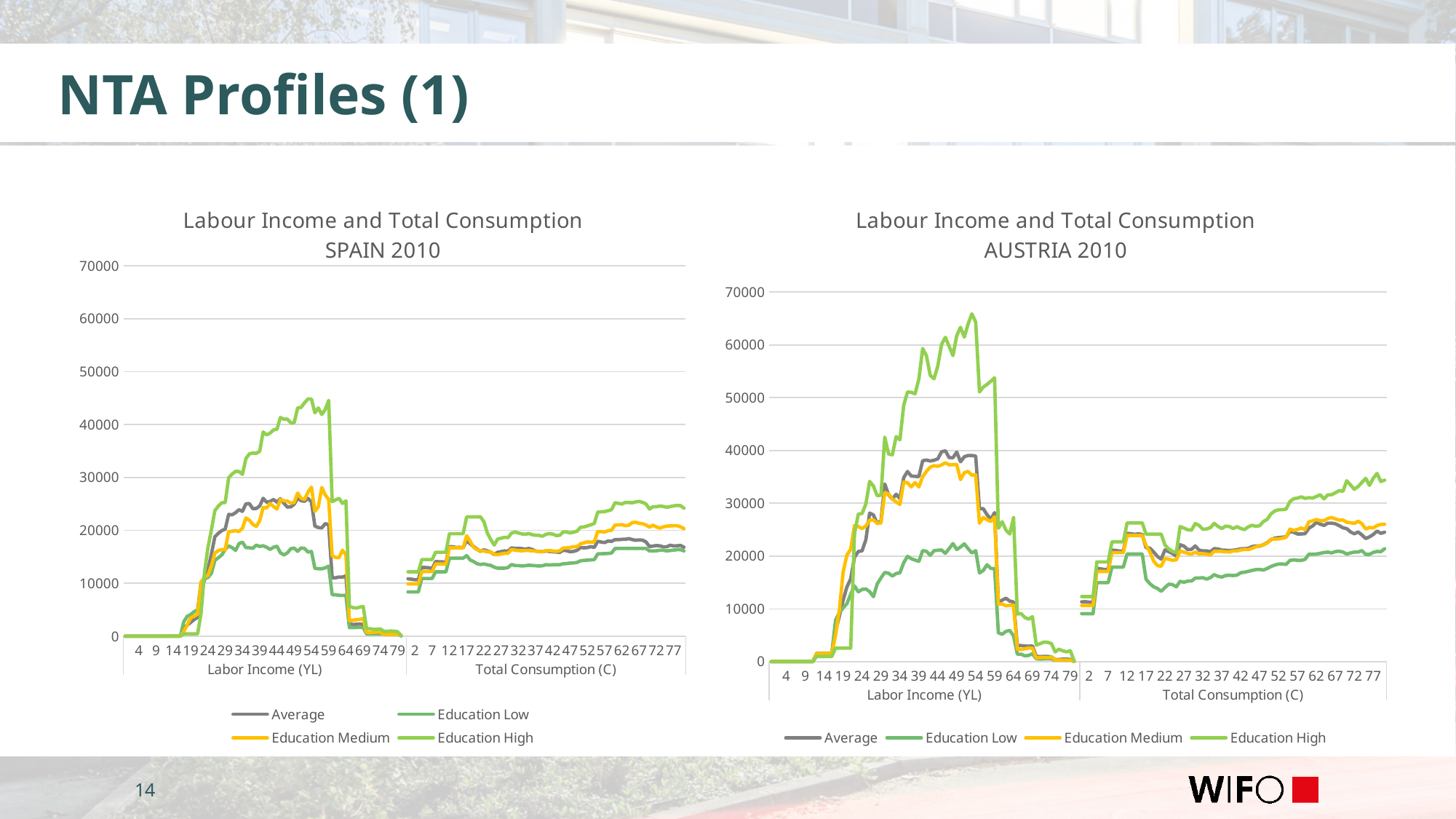
In the SPAIN 2010 chart, is the peak labor income of the Education High series greater or less than 40000? greater In the AUSTRIA 2010 chart, does the Education High series in the Total Consumption (C) section generally rise or fall with age? rise In the AUSTRIA 2010 chart, is the peak labor income of the Education High series greater or less than 60000? greater In the SPAIN 2010 chart, which series reaches the highest peak in the Labor Income (YL) section? Education High In the SPAIN 2010 chart, which series has the lowest total consumption at age 77, Education Low or Education High? Education Low In the AUSTRIA 2010 chart, is the Education High total consumption at age 77 greater or less than 30000? greater In the AUSTRIA 2010 chart, which series reaches the highest peak in the Labor Income (YL) section? Education High What is the highest value shown on the vertical axis of the AUSTRIA 2010 chart? 70000 How many series does the legend of the 'Labour Income and Total Consumption AUSTRIA 2010' chart list? 4 What are the two x-axis section labels on the SPAIN 2010 chart? Labor Income (YL) and Total Consumption (C) What kind of chart is the 'Labour Income and Total Consumption SPAIN 2010' chart? line chart